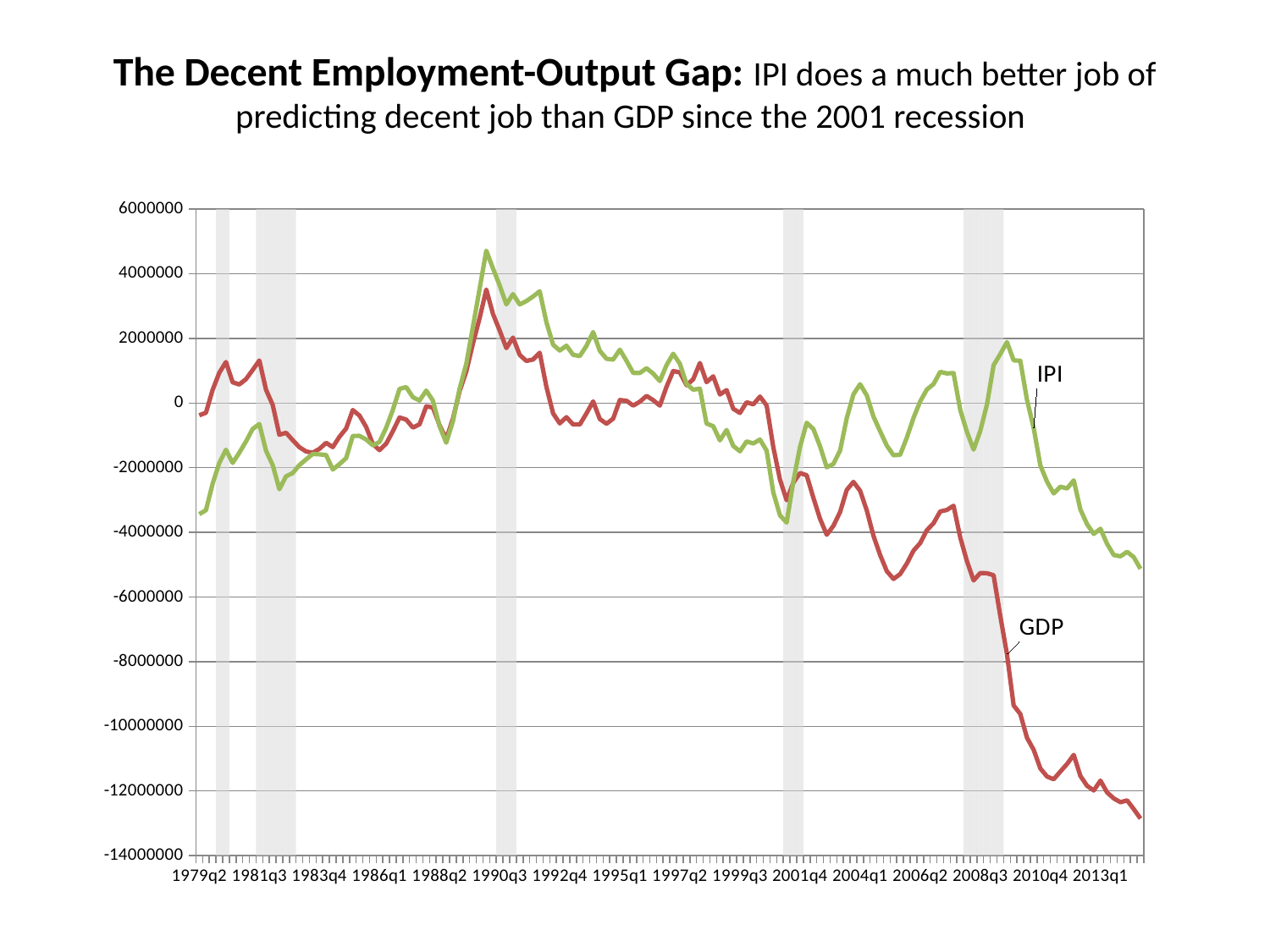
Which series reaches the lowest value on the chart? GDP What colour is the line for the IPI series? green Is the peak value of IPI around 1990 greater or less than 4000000? greater Is the value of GDP at the right end of the chart greater or less than -10000000? less At the right end of the chart (after 2013q1), which series has the higher value, IPI or GDP? IPI What kind of chart is shown on the slide? line chart Is the peak value of GDP around 1990 greater or less than 4000000? less How many shaded vertical bands appear on the chart? 5 From 2008q3 to the end of the chart, does the GDP series rise or fall overall? fall Which series reaches the highest value on the chart? IPI How many data series are plotted on the chart? 2